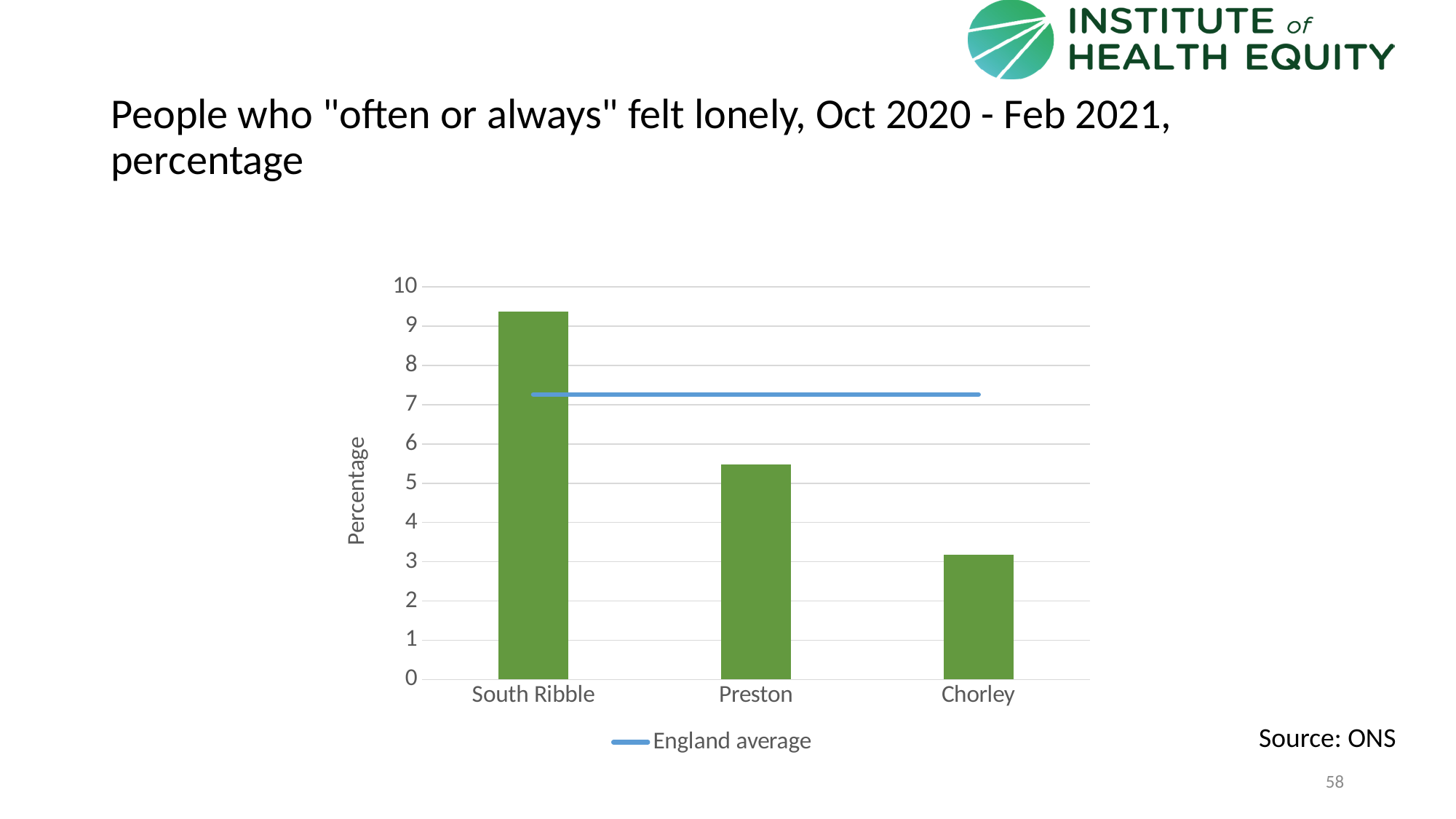
Which is larger, the value for Preston or the England average? England average Is the England average line greater or less than 7? greater What kind of chart is shown on the slide? bar chart Is the value for Preston greater or less than 6? less Which area has the highest percentage of people who often or always felt lonely? South Ribble Is the value for South Ribble greater or less than 9? greater Which area has the lowest percentage of people who often or always felt lonely? Chorley Which is larger, the value for South Ribble or the England average? South Ribble How many areas (bars) are plotted on the chart? 3 Do the bar values rise or fall from left to right across the x axis? fall